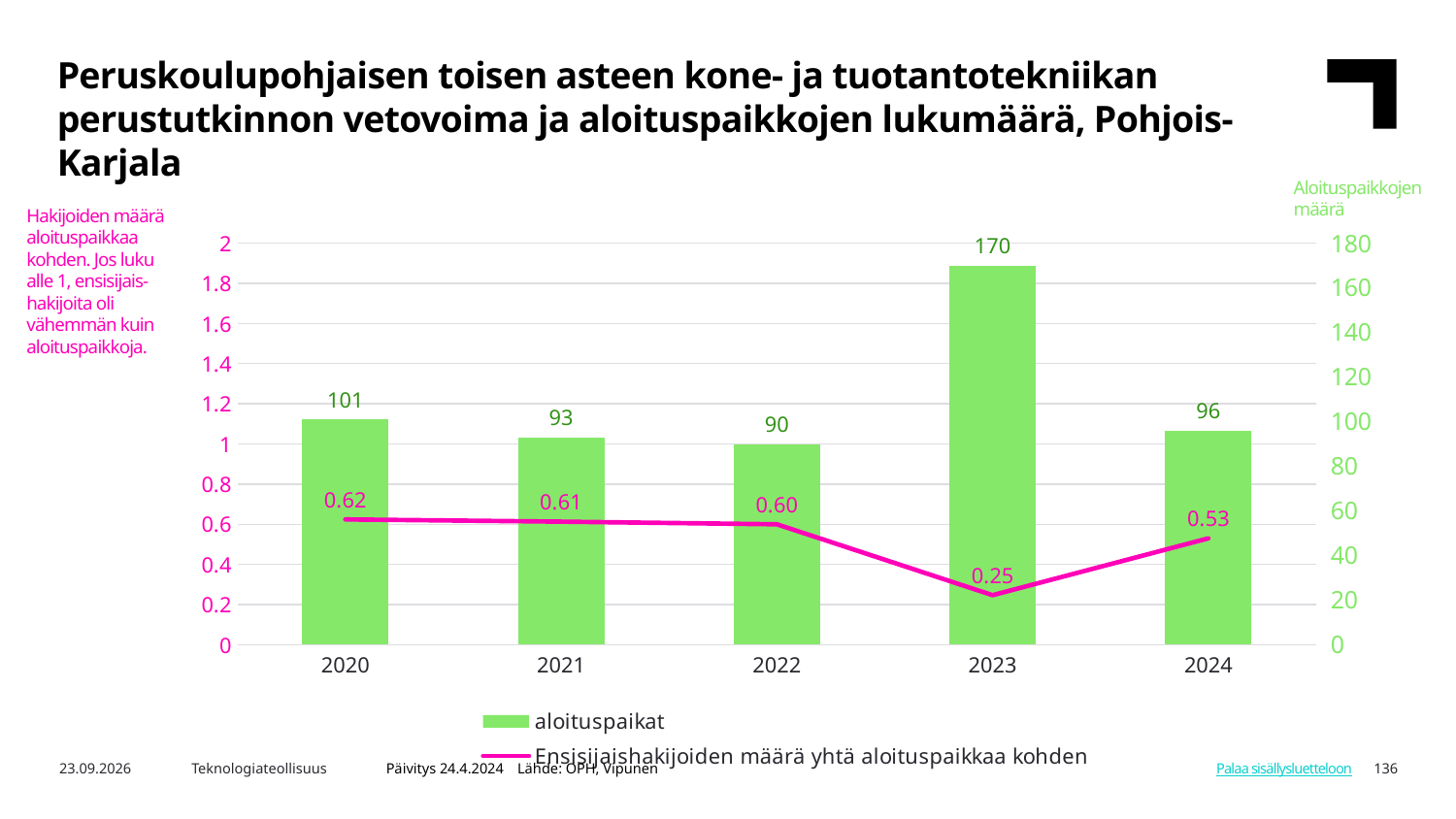
What is the value of Ensisijaishakijoiden määrä yhtä aloituspaikkaa kohden for 2020? 0.62 Which year has the lowest value of Ensisijaishakijoiden määrä yhtä aloituspaikkaa kohden? 2023 Which year has the larger aloituspaikat value, 2020 or 2021? 2020 What is the value of aloituspaikat for 2024? 96 What is the value of aloituspaikat for 2023? 170 What kind of chart is used to show the aloituspaikat series? bar chart What is the difference between the aloituspaikat values for 2023 and 2022? 80 Which year has the highest value of aloituspaikat? 2023 Is the aloituspaikat value for 2022 greater or less than 100? less What colour are the aloituspaikat bars? green How many series does the legend list? 2 How many years are shown on the x axis? 5